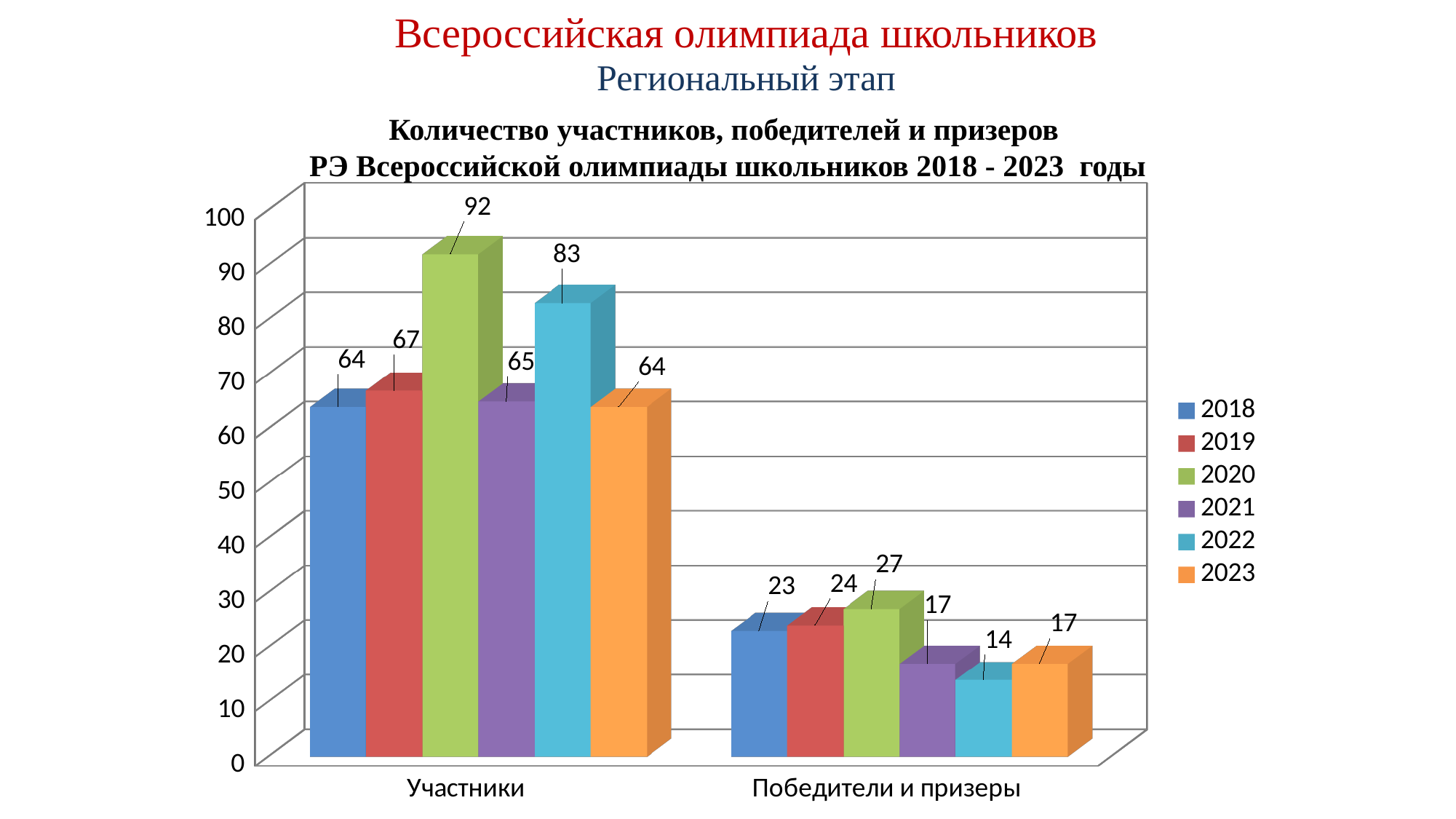
What is the value for 2020 in the Участники category? 92 What is the difference between the 2020 and 2022 values in the Участники category? 9 What is the value for 2022 in the Победители и призеры category? 14 Is the value for 2022 in the Участники category greater or less than 80? greater Which year has the lowest value in the Победители и призеры category? 2022 What kind of chart is shown on the slide? bar chart What is the difference between the 2020 and 2021 values in the Победители и призеры category? 10 How many categories are shown on the x axis? 2 Which is larger in the Победители и призеры category: the value for 2019 or the value for 2021? 2019 Which colour represents the 2023 series in the legend? orange How many series does the legend list? 6 Which year has the highest value in the Участники category? 2020